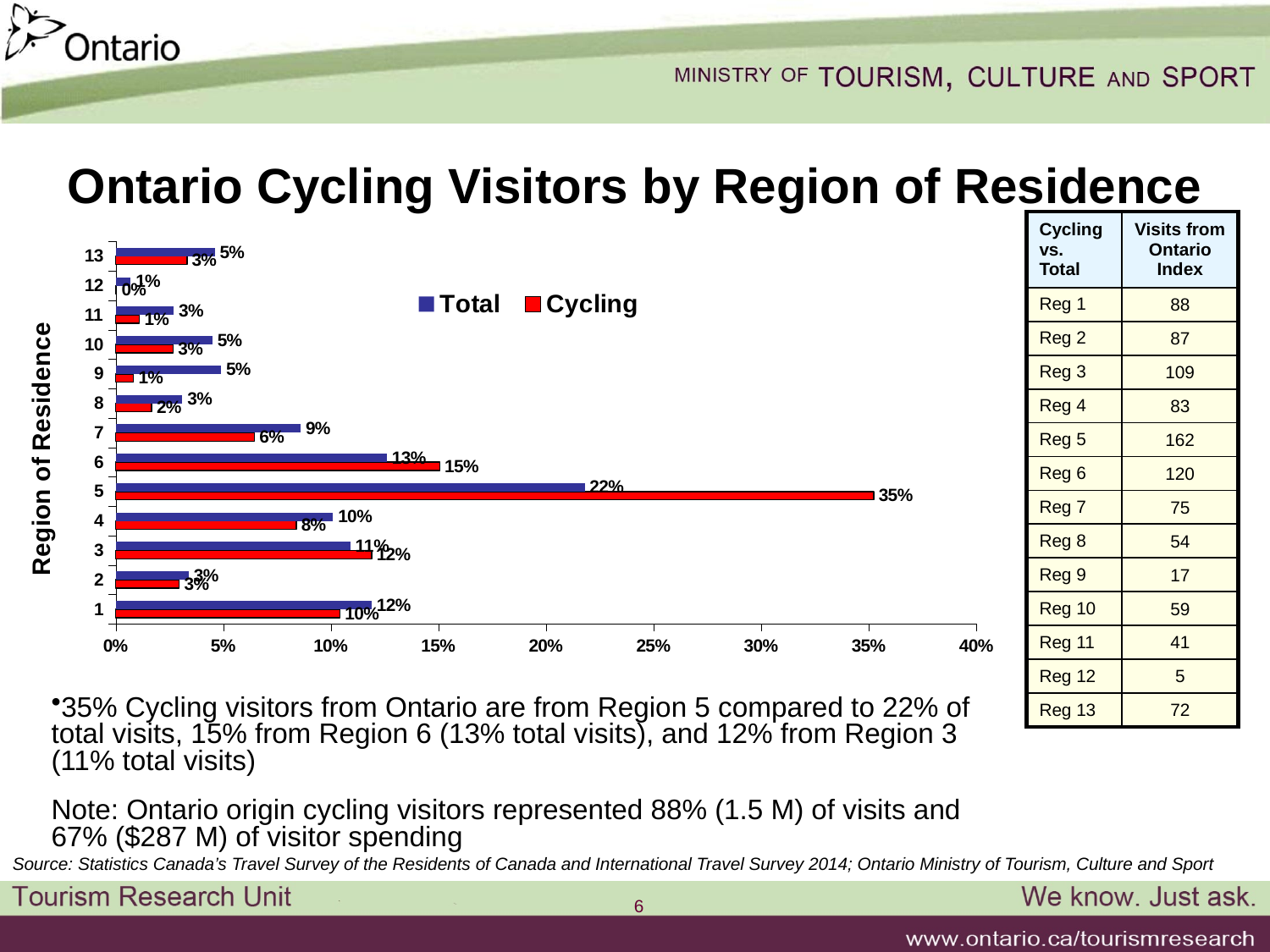
What type of chart is shown on the slide? Bar chart Which region has the highest Cycling value? Region 5 How many series does the chart legend list? 2 For Region 7, which is larger, the Total value or the Cycling value? Total What is the difference between the Cycling and Total values for Region 5? 13% Is the Cycling value for Region 5 greater or less than 30%? greater What is the Total value for Region 5? 22% How many regions of residence are shown on the chart? 13 What is the Total value for Region 1? 12% Which region has the lowest Cycling value? Region 12 What is the Cycling value for Region 6? 15% What is the Cycling value for Region 5? 35%